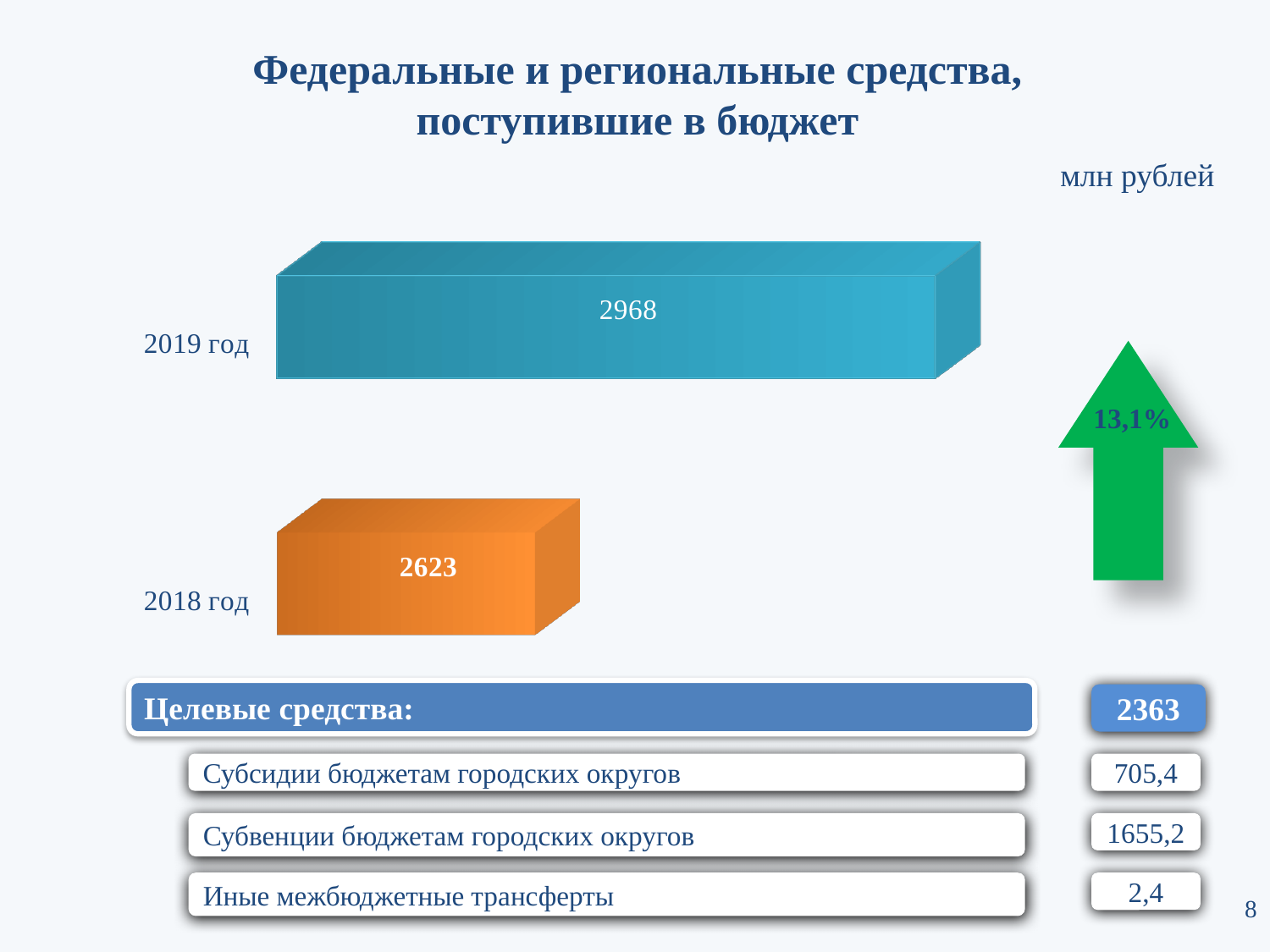
What is the value for 2018 год? 2623 Which year has the lower value? 2018 год Is the value for 2019 год larger or smaller than the value for 2018 год? larger What type of chart is shown on the slide? bar chart What is the difference between the values for 2019 год and 2018 год? 345 What is the title of the chart? Федеральные и региональные средства, поступившие в бюджет Which year has the higher value? 2019 год How many bars are shown in the chart? 2 What percentage change is shown by the green arrow next to the chart? 13,1% Did the value rise or fall from 2018 год to 2019 год? rise What is the value for 2019 год? 2968 What unit is indicated for the chart values? млн рублей